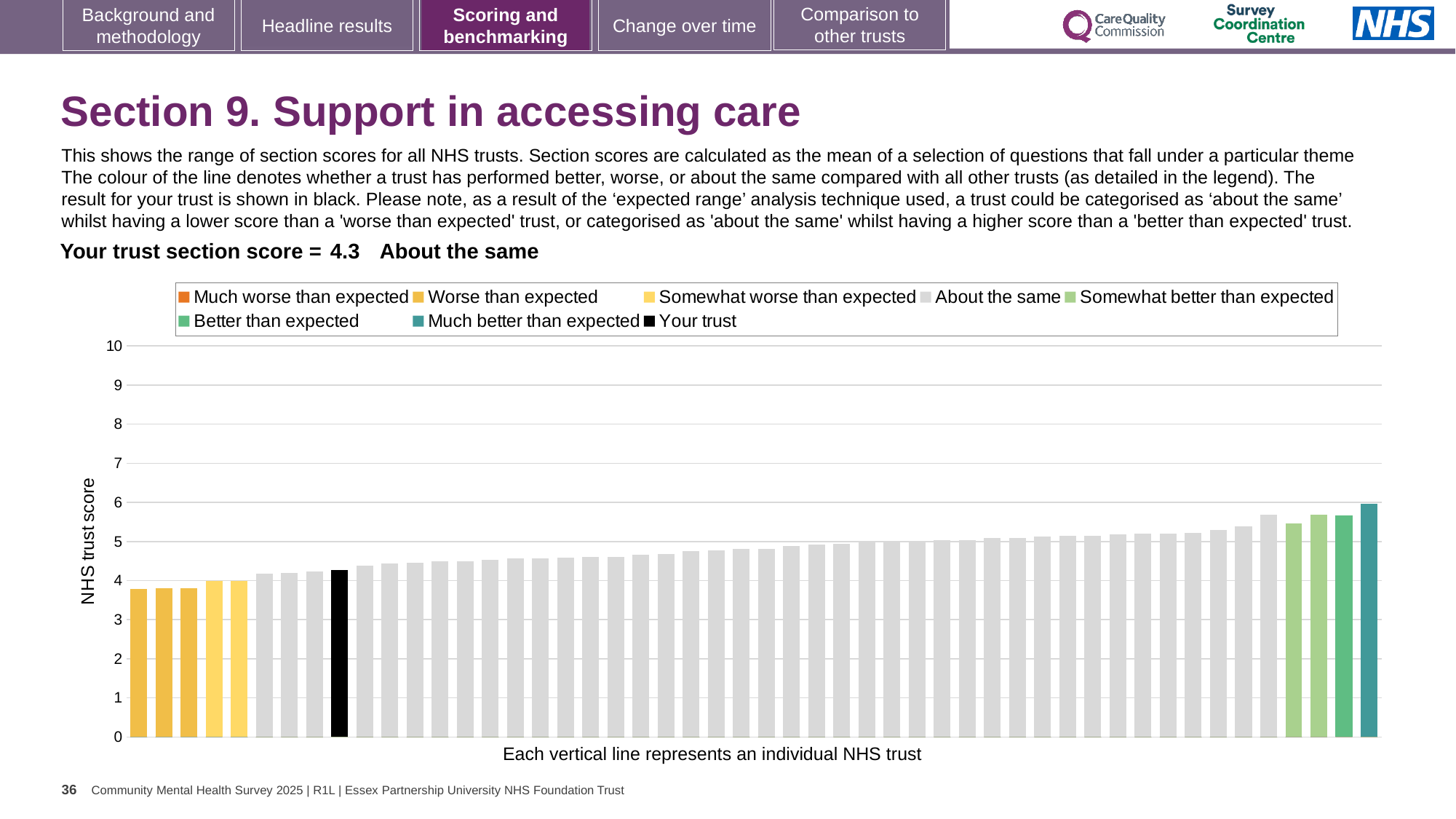
Do the bar values rise or fall from left to right along the x axis? rise Which is larger: the value for your trust (black bar) or the value of the leftmost bar? your trust How many bars are coloured as 'Much better than expected' (teal)? 1 What is the label on the vertical axis of the chart? NHS trust score What is the section score for your trust shown on the slide? 4.3 What colour is used to show your trust in the chart? black How many entries does the chart legend list? 8 What kind of chart is shown on the slide? bar chart Is the value of the tallest bar in the chart greater or less than 5? greater Which category is your trust placed in for this section? About the same Is the value of the lowest bar in the chart greater or less than 4? less Is the value for your trust (the black bar) greater or less than 4? greater